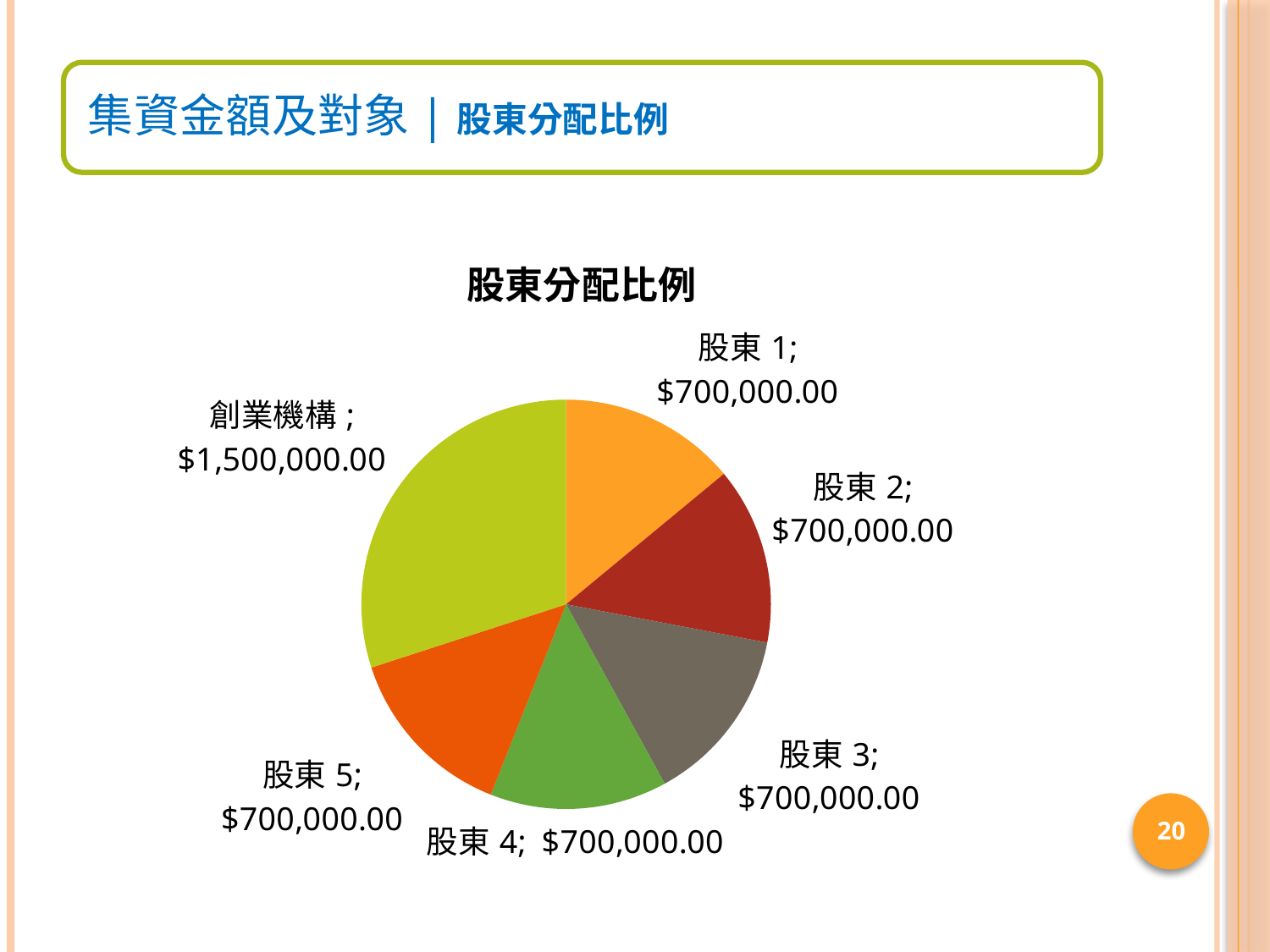
Which is larger, the value for 創業機構 or the value for 股東 1? 創業機構 What is the value for 股東 3? $700,000.00 What is the difference between the value for 創業機構 and the value for 股東 2? $800,000.00 Which category has the largest slice of the pie? 創業機構 What is the value for 創業機構? $1,500,000.00 What share of the pie does 股東 4 represent? 14% What is the value for 股東 5? $700,000.00 What is the title of the chart? 股東分配比例 What is the total of all the slices in the pie chart? $5,000,000.00 What share of the pie does 創業機構 represent? 30% What kind of chart is shown on the slide? pie chart How many slices does the pie chart have? 6